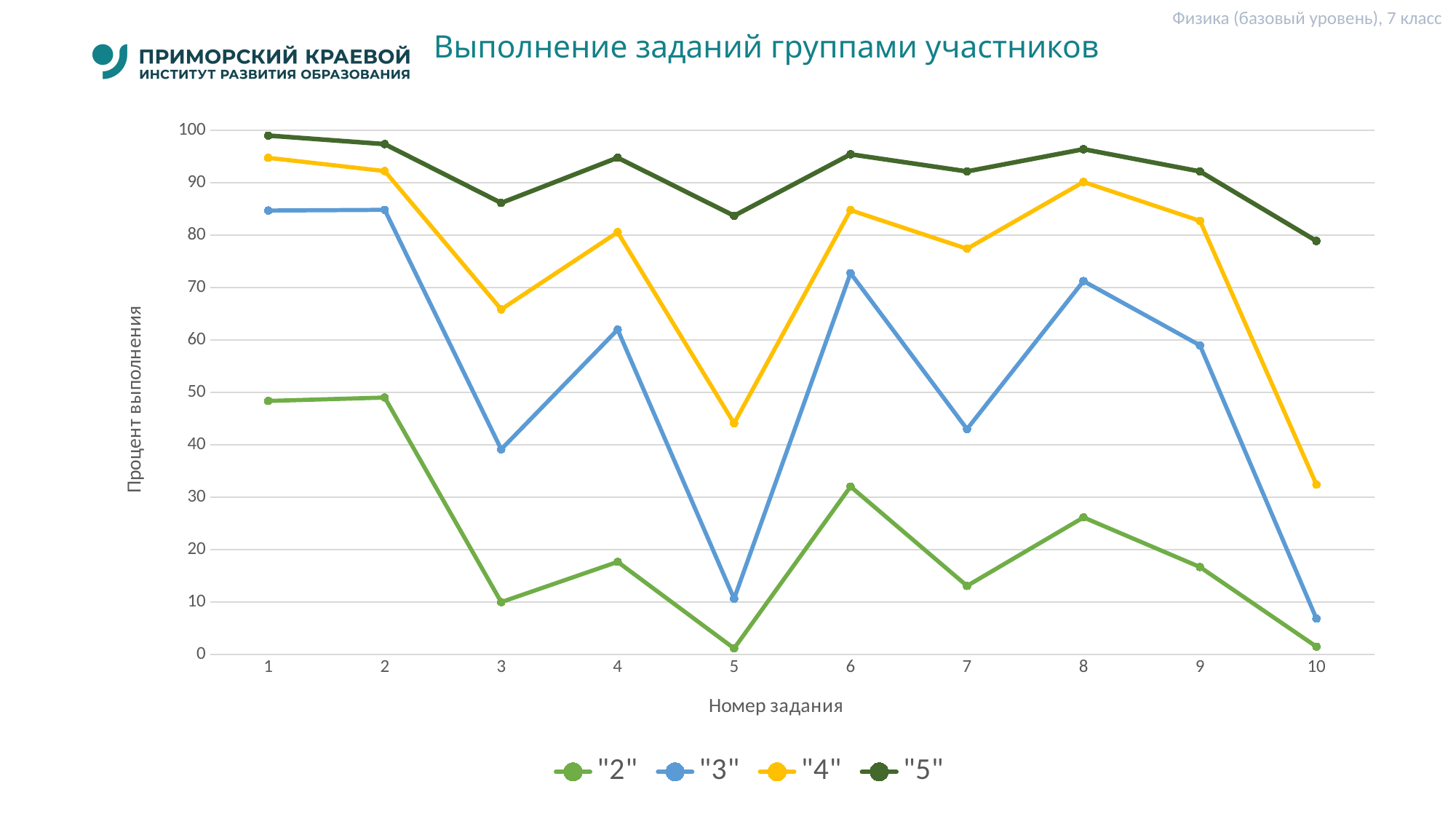
What is the title of the y axis? Процент выполнения How many task numbers are plotted along the x axis? 10 Does the line for series "5" rise or fall from task 8 to task 10? fall Is the value for series "3" at task 5 greater or less than 20? less For series "5", which task number has the lowest value? 10 Is the value for series "2" at task 1 greater or less than 40? greater What kind of chart is shown on the slide? line chart Is the value for series "5" at task 3 greater or less than 80? greater For series "4", which task number has the lowest value? 10 For series "3", is the value at task 4 or at task 6 larger? task 6 How many series does the legend list? 4